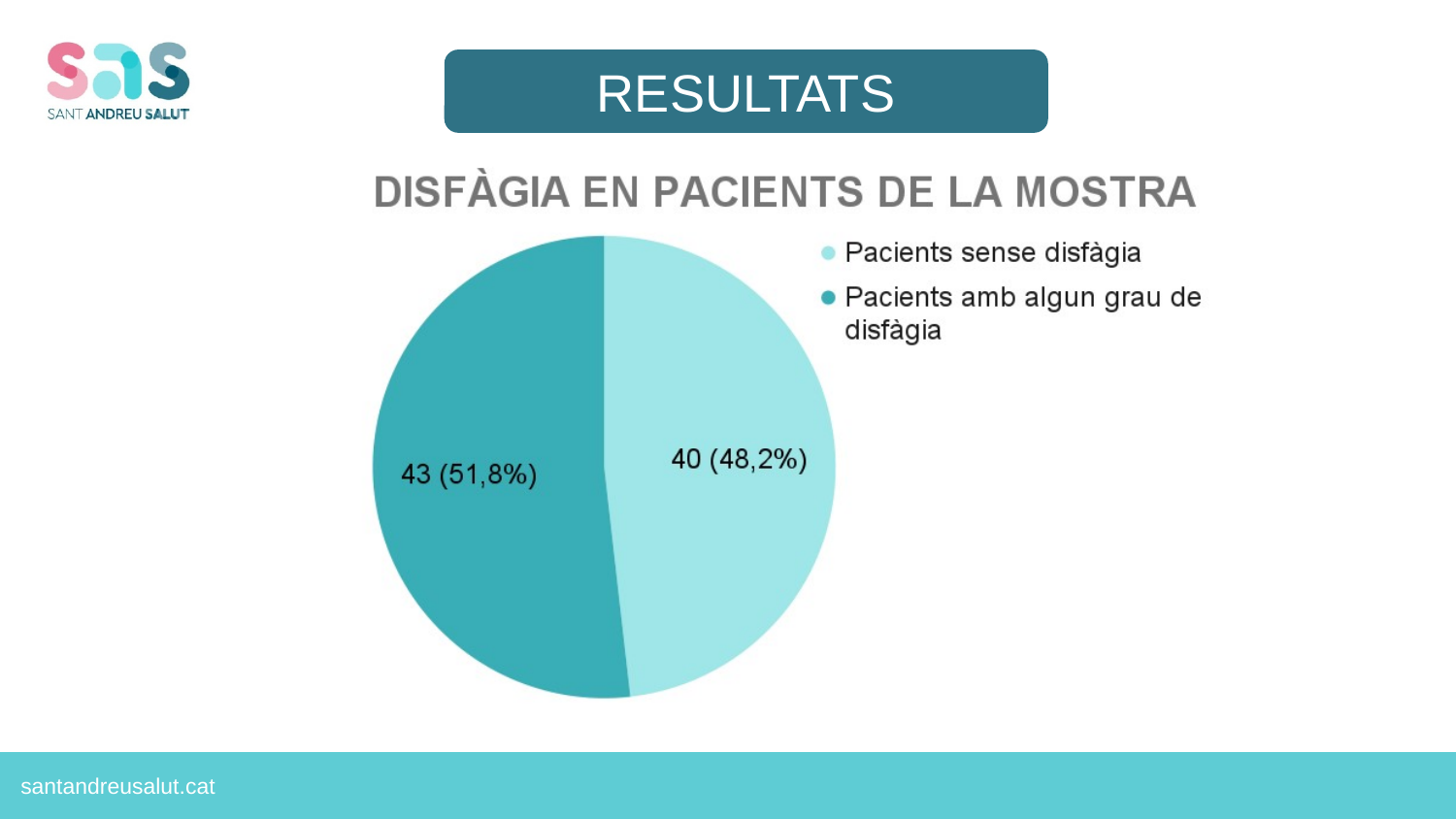
How many patients are in the 'Pacients amb algun grau de disfàgia' slice? 43 What share of the pie does 'Pacients amb algun grau de disfàgia' represent? 51,8% What is the difference in number of patients between 'Pacients amb algun grau de disfàgia' and 'Pacients sense disfàgia'? 3 Which category has the larger slice of the pie? Pacients amb algun grau de disfàgia What is the title of the chart? DISFÀGIA EN PACIENTS DE LA MOSTRA Which category has the smaller slice of the pie? Pacients sense disfàgia What share of the pie does 'Pacients sense disfàgia' represent? 48,2% How many entries does the legend list? 2 How many slices does the pie chart have? 2 How many patients are in the 'Pacients sense disfàgia' slice? 40 What type of chart is shown on the slide? pie chart What is the total number of patients represented in the pie chart? 83